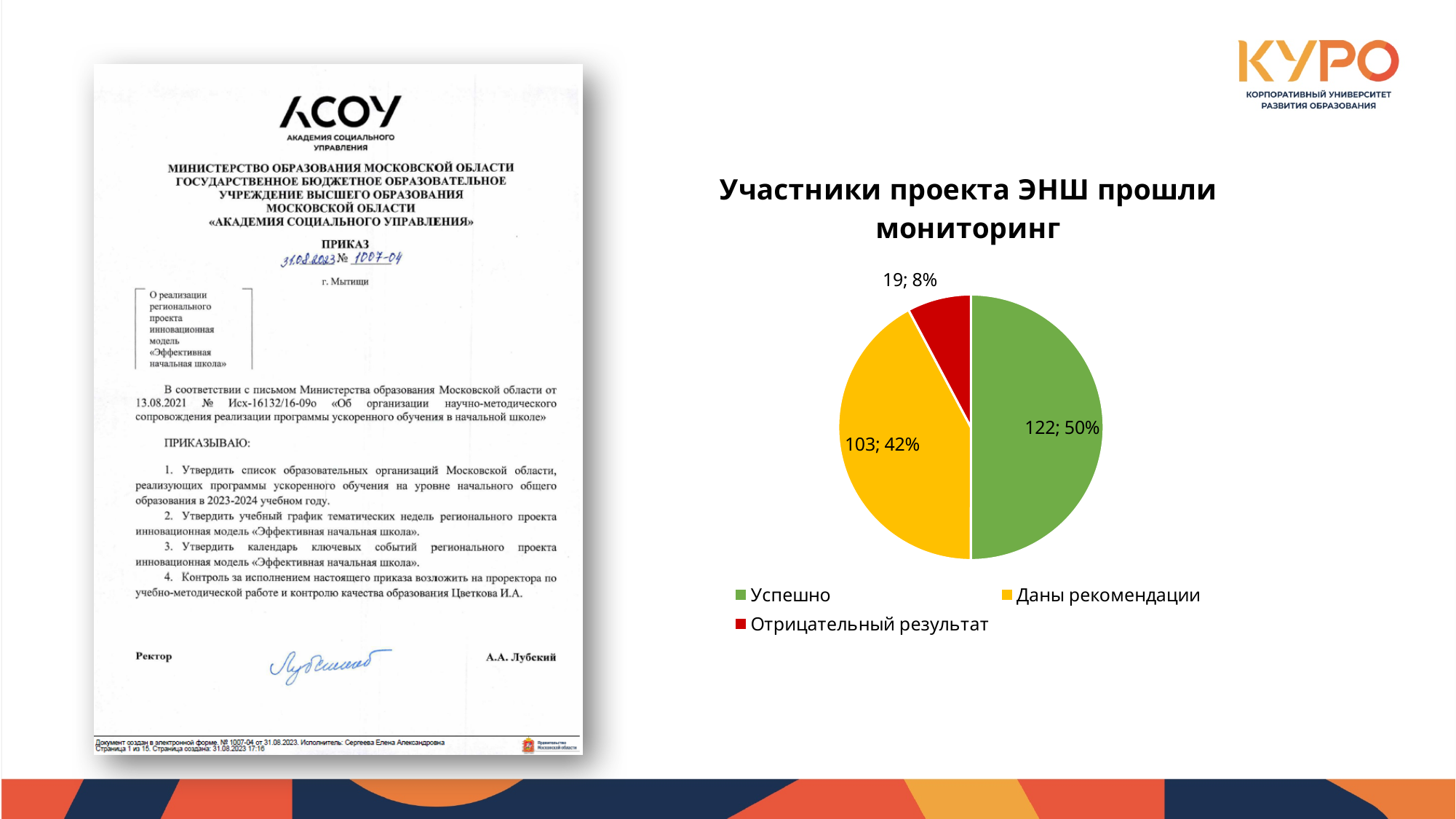
What is the value for Отрицательный результат? 19 What is the title of the chart? Участники проекта ЭНШ прошли мониторинг What share of the pie does Отрицательный результат take? 8% What is the value for Успешно? 122 What kind of chart is shown on the slide? pie chart What share of the pie does Даны рекомендации take? 42% Which category has the largest slice? Успешно What is the difference between the values for Успешно and Даны рекомендации? 19 How many entries does the legend list? 3 What is the value for Даны рекомендации? 103 Which category has the smallest slice? Отрицательный результат How many slices does the pie chart have? 3